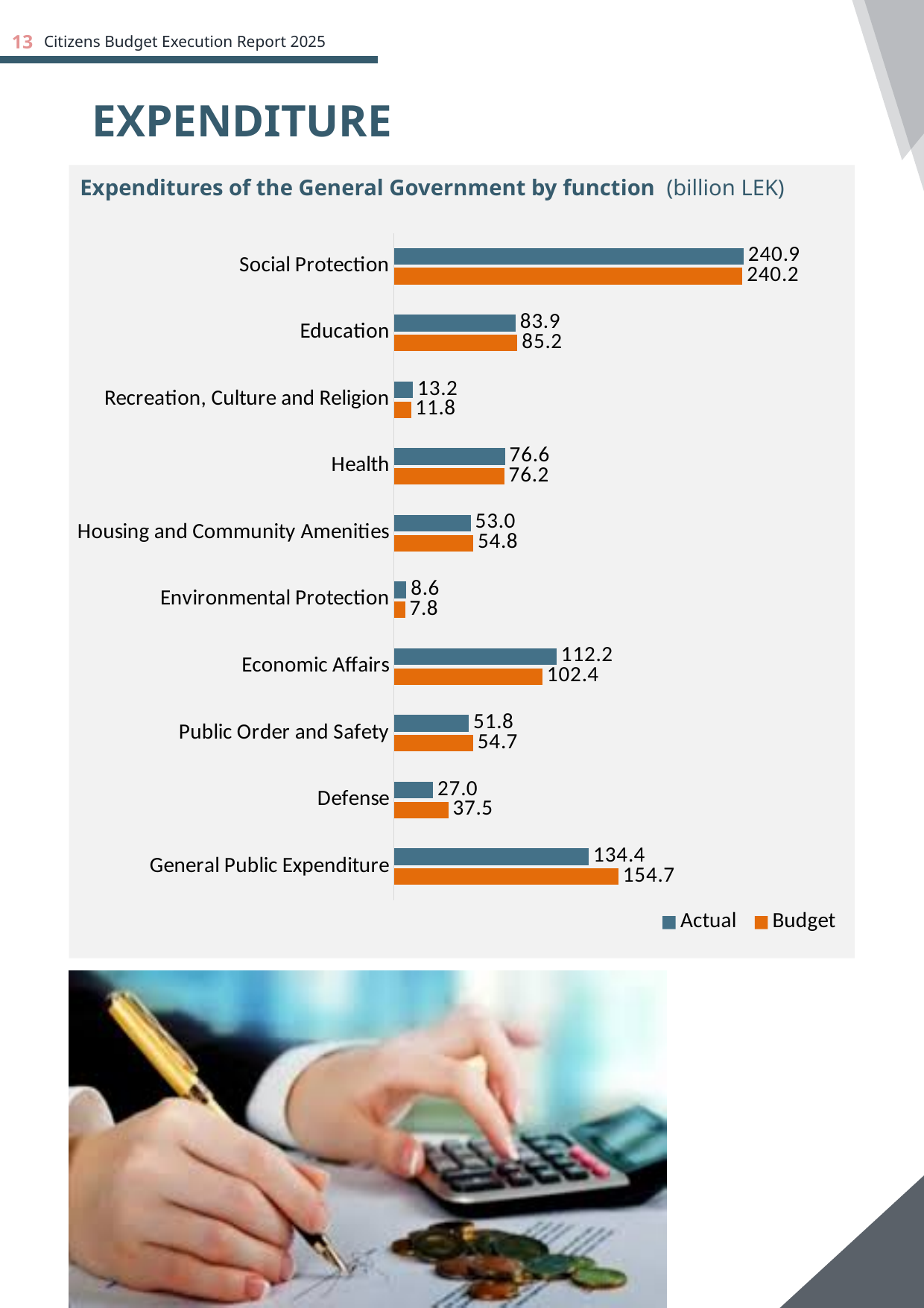
How many categories are shown in the chart? 10 How many series does the legend list? 2 What kind of chart is shown on the slide? Bar chart Which is larger for Defense, the Actual value or the Budget value? Budget Which is larger for Education, the Actual value or the Budget value? Budget Which category has the highest Actual value? Social Protection Which category has the lowest Budget value? Environmental Protection What is the Actual value for Social Protection? 240.9 What is the difference between the Budget and Actual values for General Public Expenditure? 20.3 What is the Budget value for Defense? 37.5 What is the difference between the Actual and Budget values for Economic Affairs? 9.8 What is the Actual value for Economic Affairs? 112.2